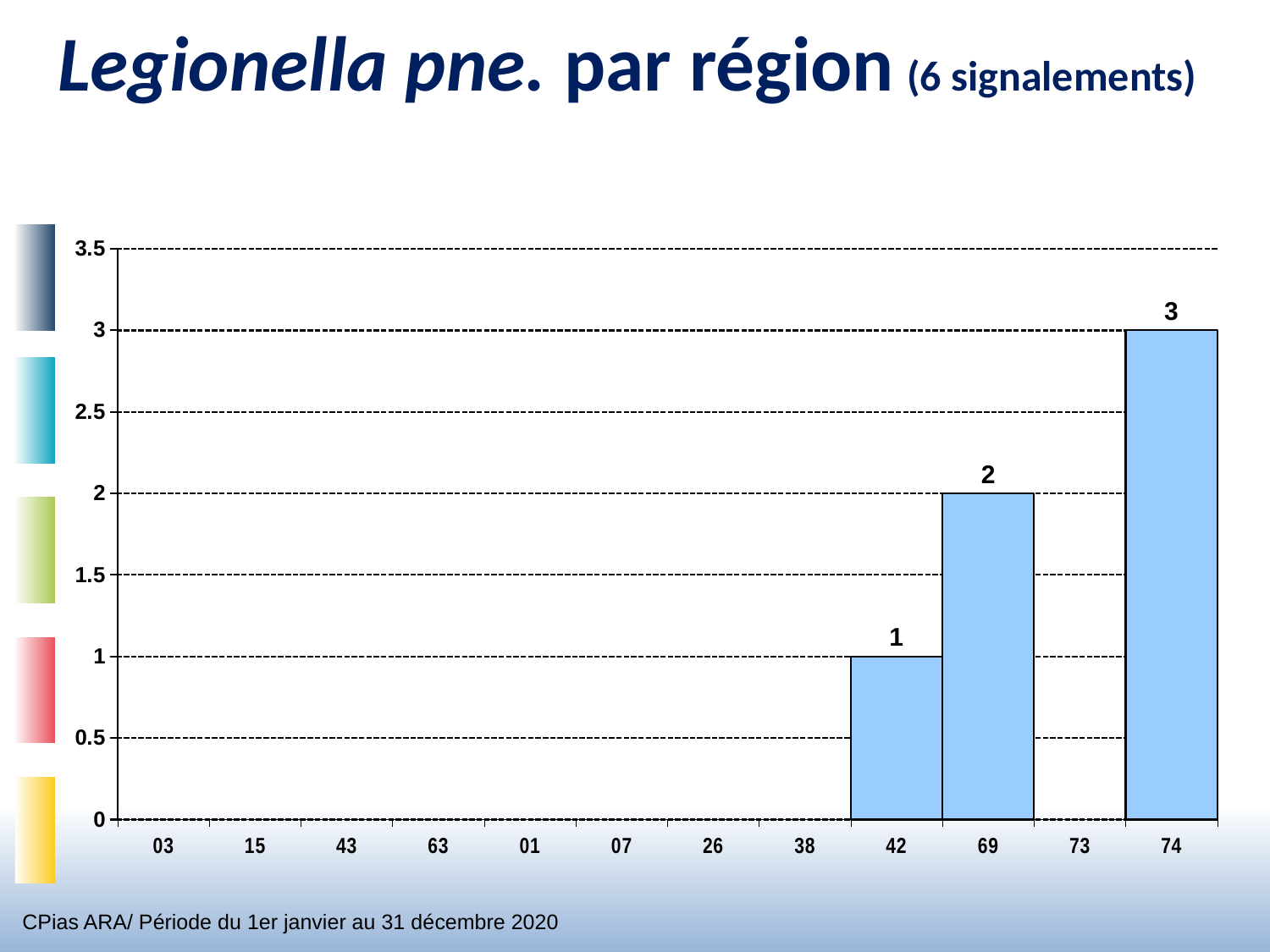
How many categories are shown on the x axis? 12 What is the value for category 42? 1 What is the value for category 74? 3 Which category has the highest value? 74 What is the title of the slide? Legionella pne. par région (6 signalements) What is the value for category 69? 2 Which is larger, the value for 69 or the value for 42? 69 How many categories have a visible bar? 3 What is the total of the three labelled bars? 6 What is the difference between the values for 74 and 42? 2 What kind of chart is shown? bar chart Is the value for 74 greater or less than 2.5? greater